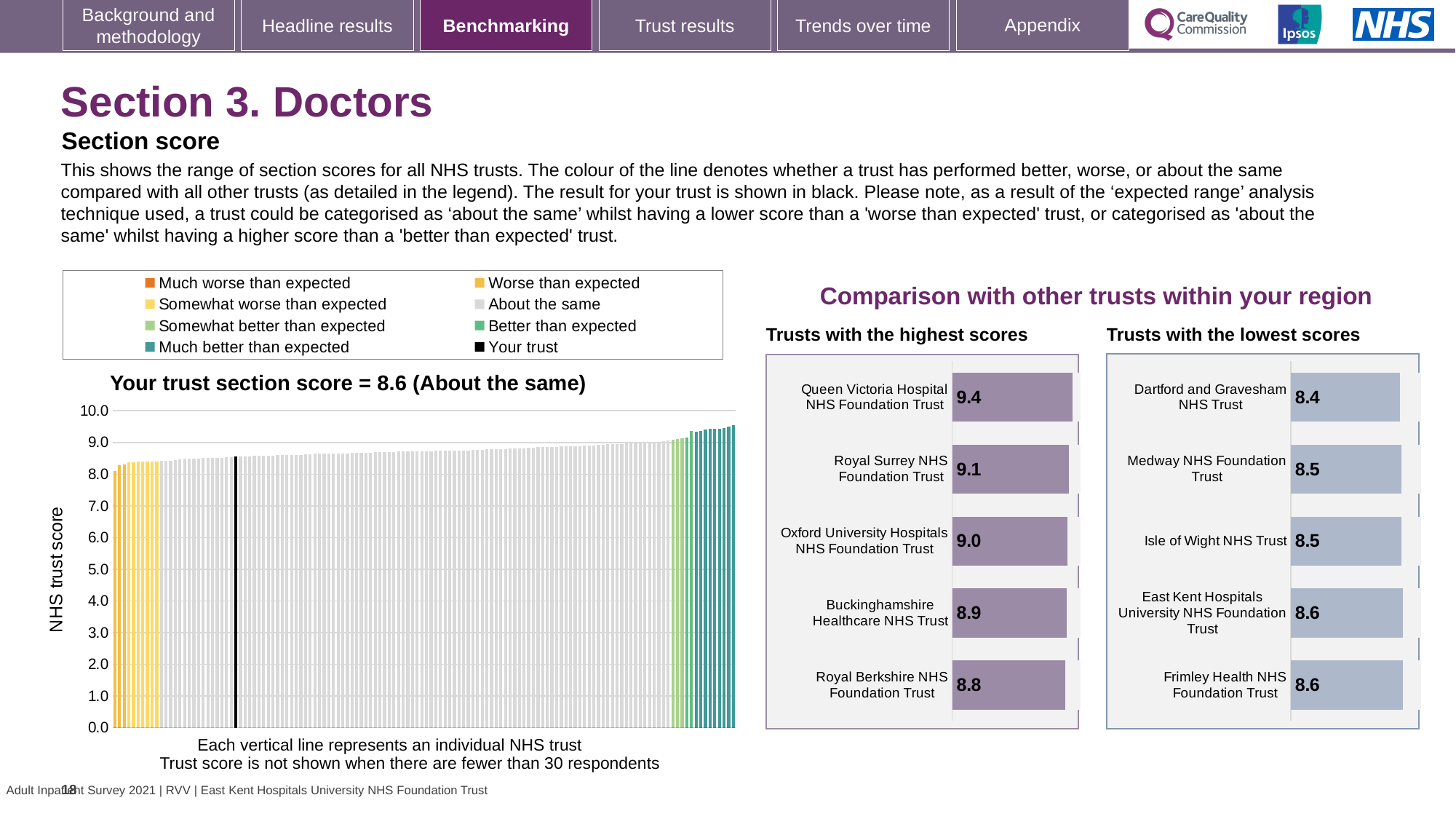
In the 'Trusts with the highest scores' chart, what is the difference between the scores of Queen Victoria Hospital NHS Foundation Trust and Royal Surrey NHS Foundation Trust? 0.3 In the 'Trusts with the lowest scores' chart, which has the higher score: Medway NHS Foundation Trust or East Kent Hospitals University NHS Foundation Trust? East Kent Hospitals University NHS Foundation Trust How many entries does the legend above the left chart list? 8 How many trusts are shown in the 'Trusts with the highest scores' chart? 5 In the 'Trusts with the highest scores' chart, what is the score for Royal Berkshire NHS Foundation Trust? 8.8 According to the title of the chart on the left, what is your trust's section score? 8.6 In the 'Trusts with the lowest scores' chart, what is the score for Dartford and Gravesham NHS Trust? 8.4 In the 'Trusts with the lowest scores' chart, which trust has the lowest score? Dartford and Gravesham NHS Trust In the 'Trusts with the highest scores' chart, which trust has the highest score? Queen Victoria Hospital NHS Foundation Trust In the 'Trusts with the lowest scores' chart, what is the score for Frimley Health NHS Foundation Trust? 8.6 In the 'Trusts with the highest scores' chart, what is the score for Queen Victoria Hospital NHS Foundation Trust? 9.4 What kind of chart is the 'Your trust section score' chart on the left? Bar chart